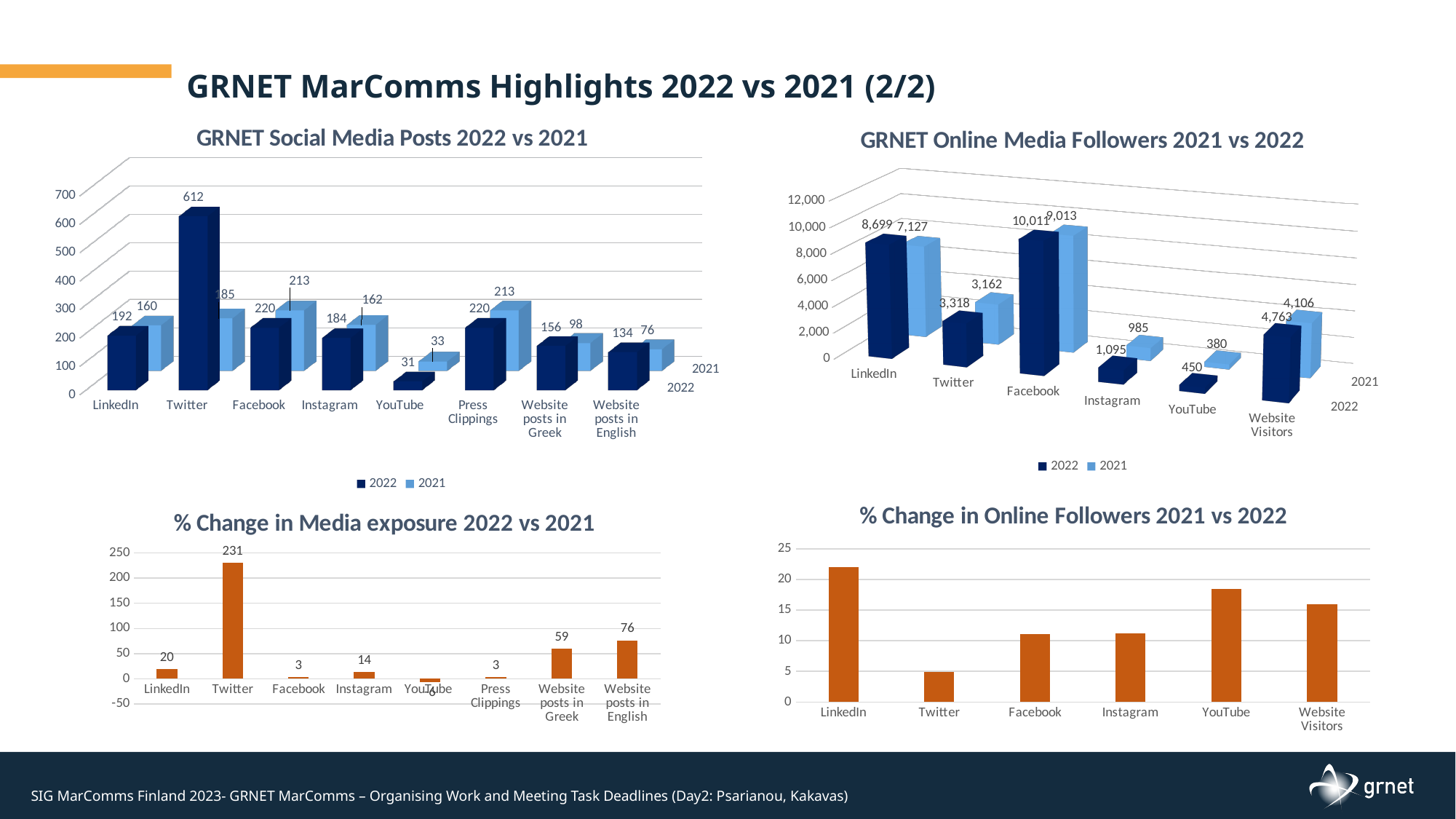
In the 'GRNET Social Media Posts 2022 vs 2021' chart, which category has the highest 2022 value? Twitter In the 'GRNET Online Media Followers 2021 vs 2022' chart, is the 2022 value for LinkedIn or for Website Visitors larger? LinkedIn In the '% Change in Online Followers 2021 vs 2022' chart, is the value for LinkedIn greater or less than 20? greater In the 'GRNET Social Media Posts 2022 vs 2021' chart, how many categories are shown on the x axis? 8 What kind of chart is the '% Change in Online Followers 2021 vs 2022' chart? Bar chart In the '% Change in Media exposure 2022 vs 2021' chart, which category has the highest value? Twitter In the '% Change in Media exposure 2022 vs 2021' chart, what is the value for Website posts in English? 76 In the 'GRNET Online Media Followers 2021 vs 2022' chart, which category has the lowest 2021 value? YouTube In the 'GRNET Online Media Followers 2021 vs 2022' chart, what is the 2022 value for Facebook? 10,011 In the 'GRNET Social Media Posts 2022 vs 2021' chart, how many posts did Twitter have in 2022? 612 How many series does the legend of the 'GRNET Online Media Followers 2021 vs 2022' chart list? 2 In the 'GRNET Social Media Posts 2022 vs 2021' chart, what is the difference between the 2022 and 2021 values for Website posts in Greek? 58